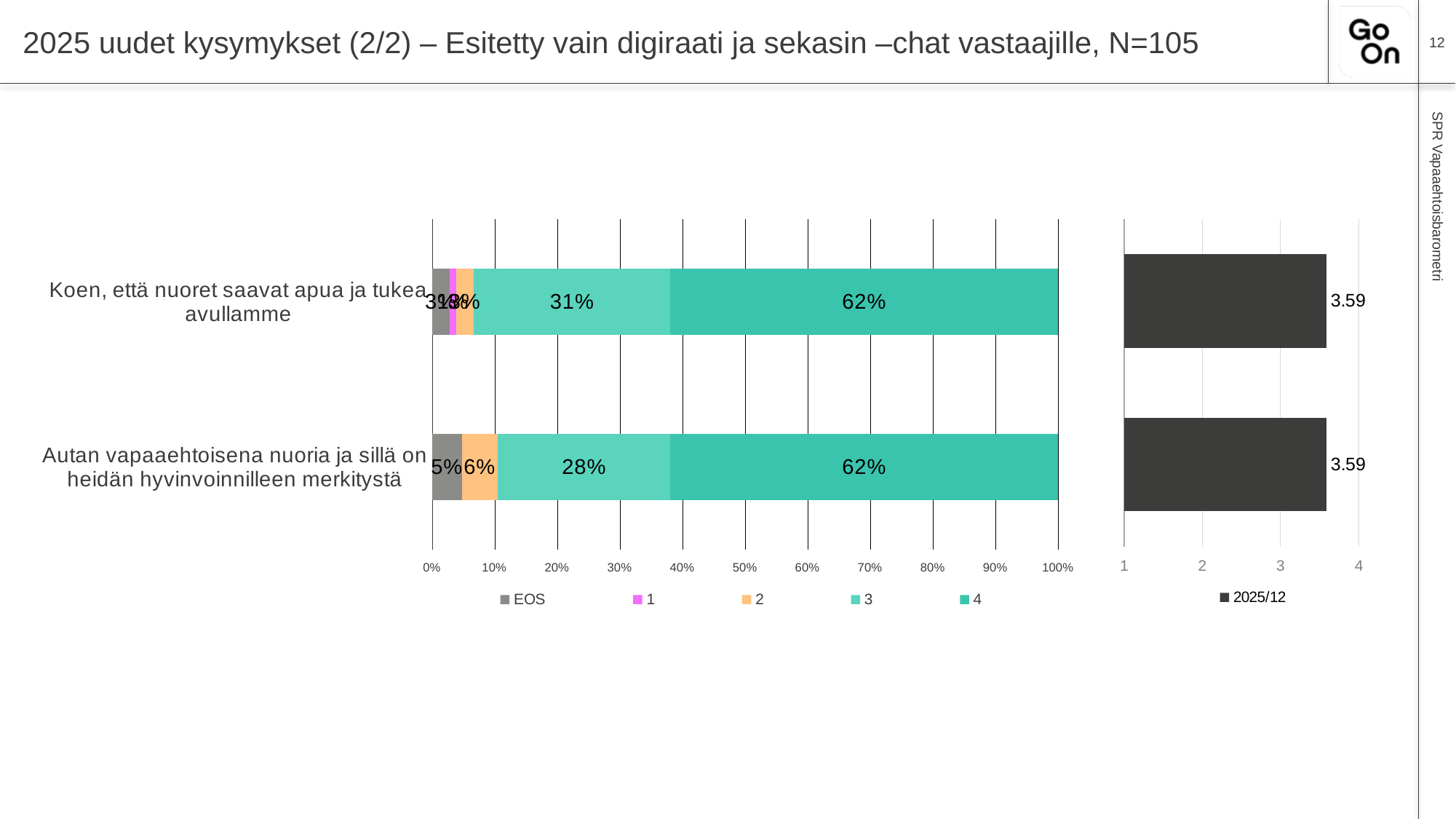
In the stacked bar chart on the left, what percentage gave a rating of 2 for "Autan vapaaehtoisena nuoria ja sillä on heidän hyvinvoinnilleen merkitystä"? 6% In the stacked bar chart on the left, what is the difference between the rating-3 shares of the two statements? 3% In the stacked bar chart on the left, what percentage of respondents gave a rating of 4 for "Autan vapaaehtoisena nuoria ja sillä on heidän hyvinvoinnilleen merkitystä"? 62% In the stacked bar chart on the left, what percentage of respondents gave a rating of 3 for "Koen, että nuoret saavat apua ja tukea avullamme"? 31% What type of chart is the chart on the right of the slide? Bar chart What is the name of the series shown in the legend of the chart on the right? 2025/12 In the stacked bar chart on the left, which statement has the larger share of rating 3? Koen, että nuoret saavat apua ja tukea avullamme In the stacked bar chart on the left, what is the EOS share for "Autan vapaaehtoisena nuoria ja sillä on heidän hyvinvoinnilleen merkitystä"? 5% How many series does the legend of the stacked bar chart on the left list? 5 In the chart on the right, what is the 2025/12 value for "Koen, että nuoret saavat apua ja tukea avullamme"? 3.59 In the chart on the right, what is the 2025/12 value for "Autan vapaaehtoisena nuoria ja sillä on heidän hyvinvoinnilleen merkitystä"? 3.59 How many statements (categories) are shown in the stacked bar chart on the left? 2